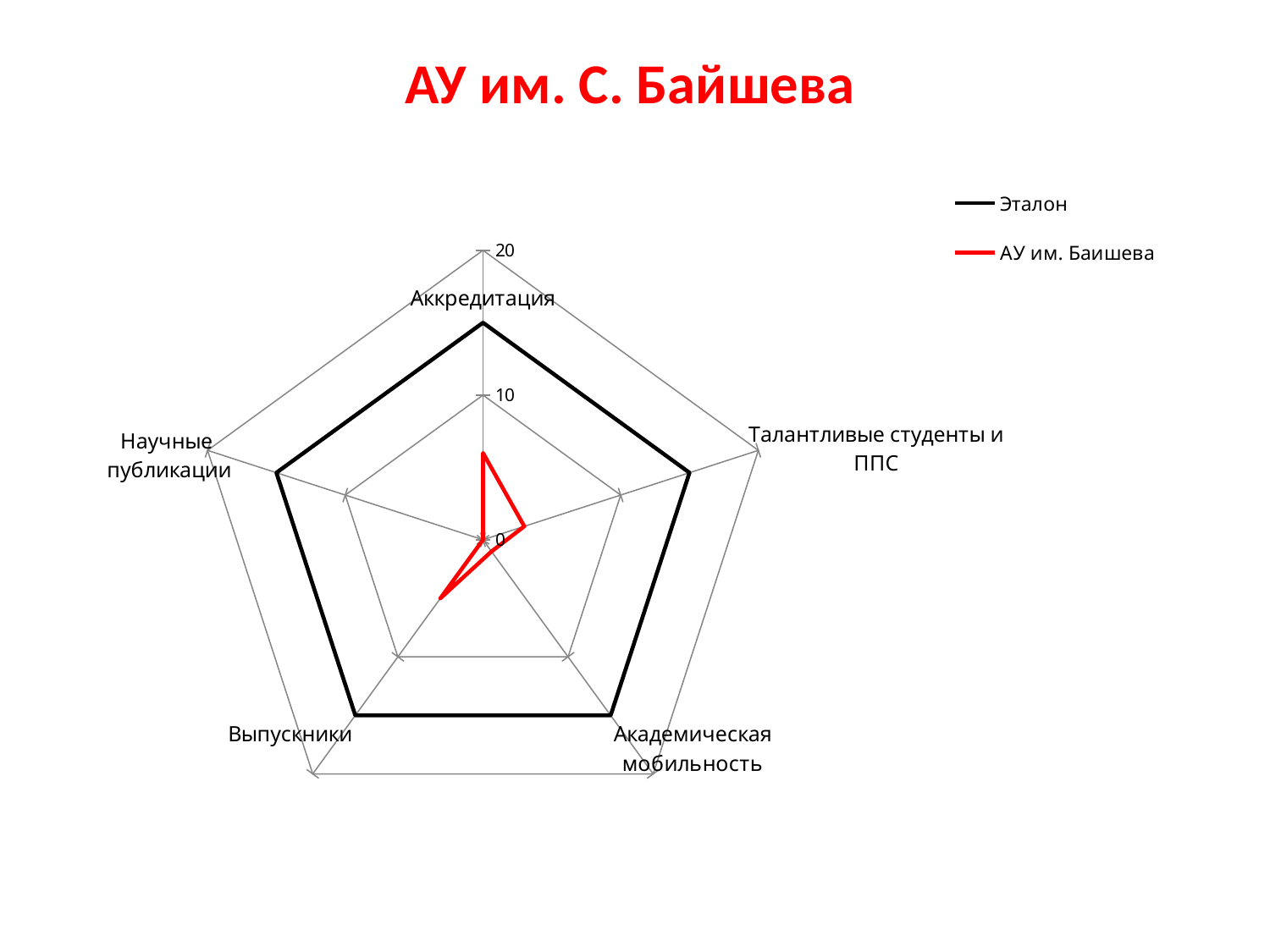
How many categories (axes) does the radar chart have? 5 What kind of chart is shown on the slide? Radar chart How many series does the legend list? 2 Is the Эталон value for Аккредитация greater or less than 10? greater For Выпускники, which series has the larger value, Эталон or АУ им. Баишева? Эталон Which two series are listed in the legend? Эталон and АУ им. Баишева For the АУ им. Баишева series, which is larger: the value for Аккредитация or the value for Талантливые студенты и ППС? Аккредитация For the АУ им. Баишева series, which category has the highest value? Аккредитация What colour is the line for the Эталон series? Black Is the Эталон value for Научные публикации greater or less than 20? less Is the АУ им. Баишева value for Талантливые студенты и ППС greater or less than 10? less